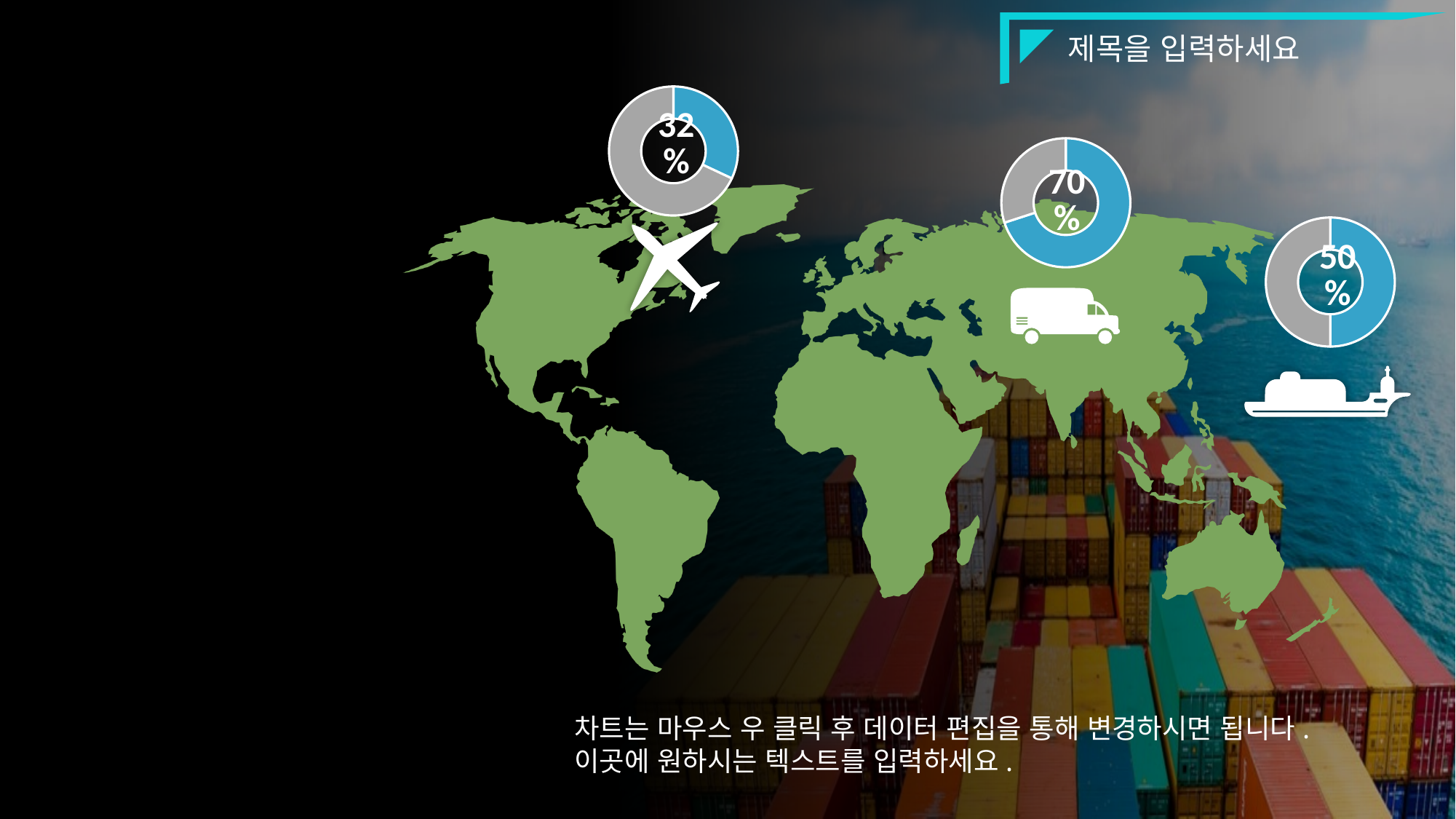
Which of the three donut charts shows the lowest percentage: the one above the airplane, the truck, or the ship? The one above the airplane (32%) What percentage is shown in the donut chart above the truck icon? 70% What is the difference between the percentage in the donut chart above the truck and the one above the ship? 20 percentage points What percentage is shown in the donut chart above the ship icon? 50% How many slices does each donut chart on the slide have? 2 What two colours are used for the slices in the donut charts? Blue and gray What kind of chart is used to display the percentages on the slide? Donut (pie) chart Is the percentage in the donut chart above the ship larger or smaller than the one above the airplane? Larger What is the difference between the percentage in the donut chart above the truck and the one above the airplane? 38 percentage points Which of the three donut charts shows the highest percentage: the one above the airplane, the truck, or the ship? The one above the truck (70%) What percentage is shown in the donut chart above the airplane icon? 32% How many donut charts are on the slide? 3